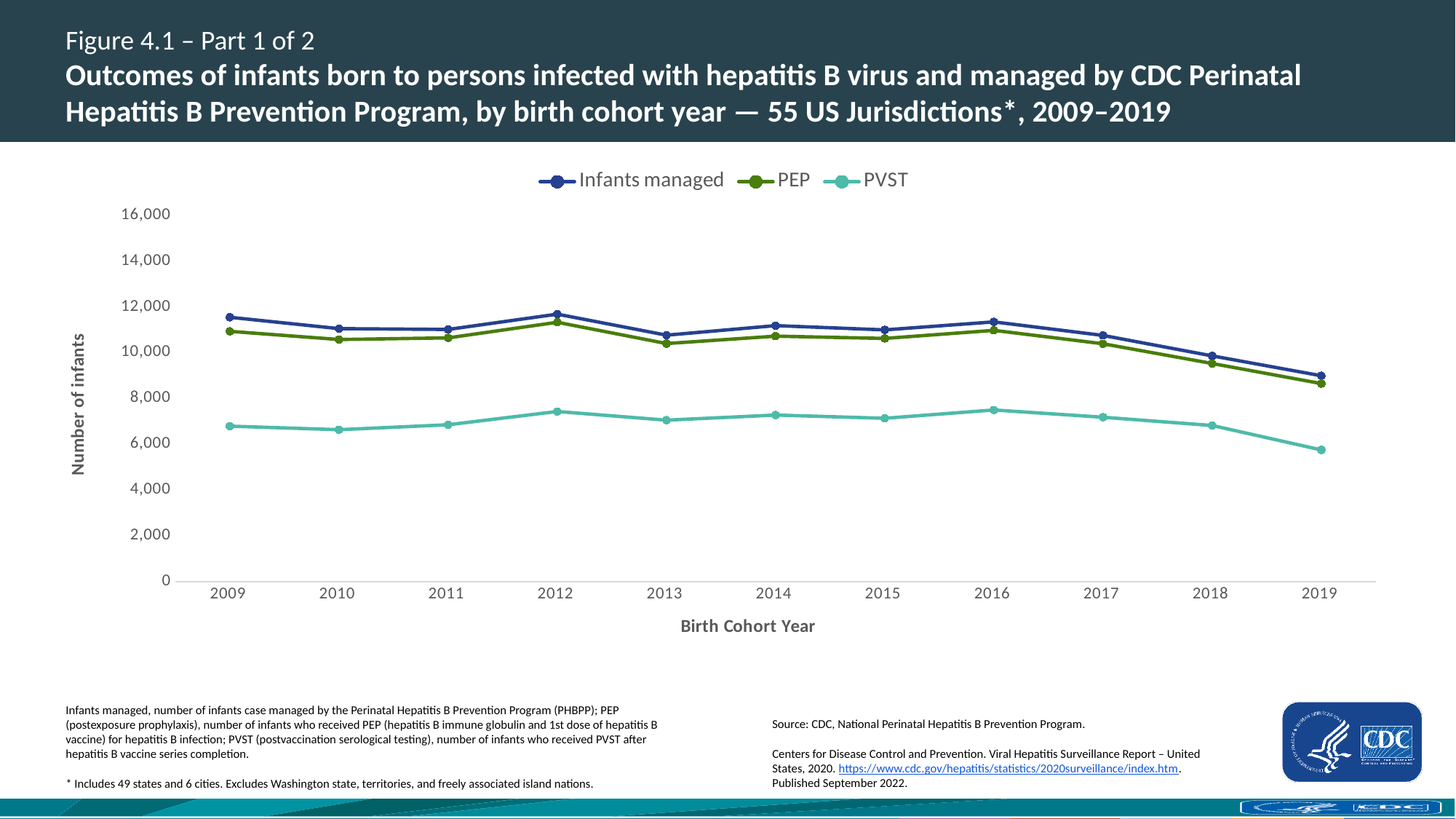
How many series does the legend list? 3 What kind of chart is shown on the slide? Line chart Which series has the lowest values across all years? PVST What is the title of the y axis? Number of infants Which is larger in 2015, Infants managed or PVST? Infants managed How many birth cohort years are plotted along the x axis? 11 In which year is the PVST series at its lowest? 2019 Is the value for PEP in 2012 greater or less than 10,000? greater Do the values for Infants managed rise or fall from 2016 to 2019? Fall In which year is the Infants managed series at its lowest? 2019 Is the value for Infants managed in 2019 greater or less than 10,000? less Is the value for PVST in 2019 greater or less than 6,000? less